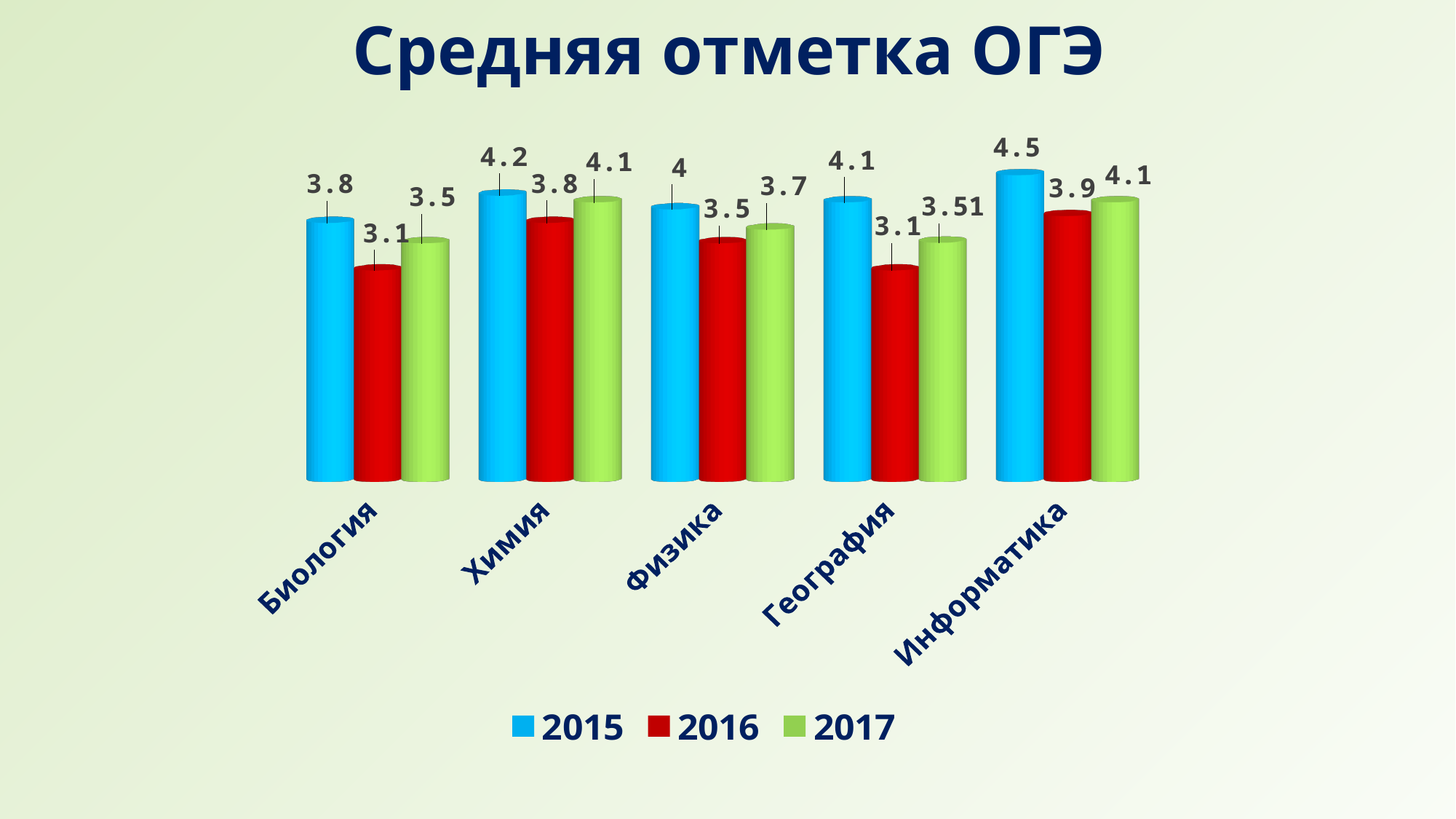
How many series does the legend list? 3 What is the value for Биология in 2015? 3.8 Which is larger: the 2017 value for Физика or the 2017 value for Химия? Химия What is the value for Химия in 2017? 4.1 What is the difference between the 2015 and 2016 values for География? 1 Which category has the lowest value in 2017? Биология How many categories are shown on the x axis? 5 What is the value for Физика in 2016? 3.5 Which category has the highest value in 2015? Информатика What kind of chart is shown on the slide? Bar chart What is the title of the chart? Средняя отметка ОГЭ What is the value for География in 2017? 3.51